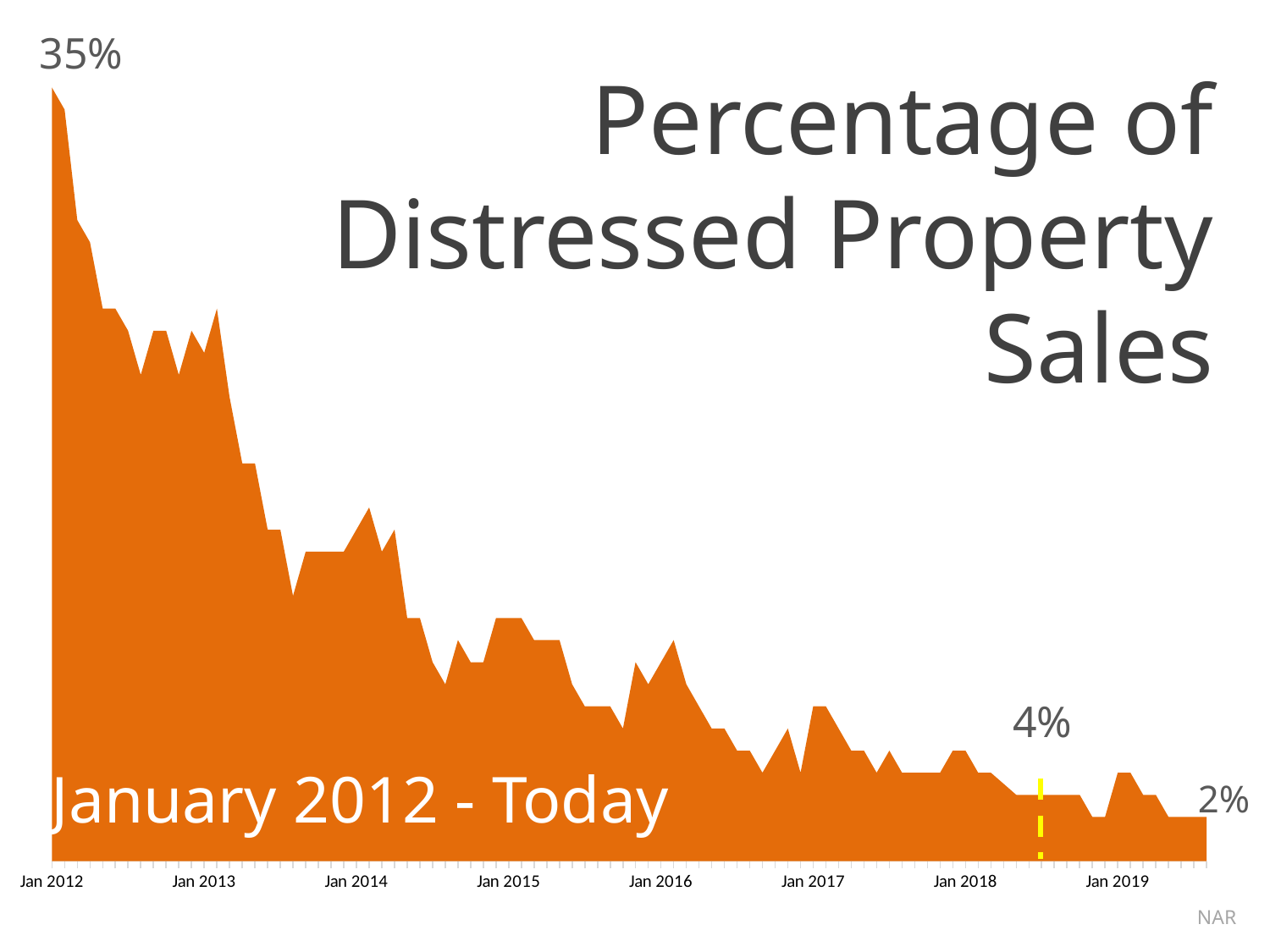
At which point on the x axis is the percentage of distressed property sales highest? Jan 2012 What percentage of distressed property sales is labeled at the start of the chart in January 2012? 35% How many year labels are shown along the x axis? 8 What percentage is labeled at the most recent point at the right end of the chart? 2% Does the percentage of distressed property sales rise or fall from January 2012 to today? Fall Which is larger: the labeled value at the dashed line in 2018 or the labeled value at the end of the chart? The value at the dashed line in 2018 What is the title of the chart? Percentage of Distressed Property Sales What time period does the chart cover according to the text on the slide? January 2012 - Today What percentage is labeled at the dashed vertical line in 2018? 4% What type of chart is shown on the slide? Area chart What is the difference between the labeled value in January 2012 and the labeled value at the end of the chart? 33%